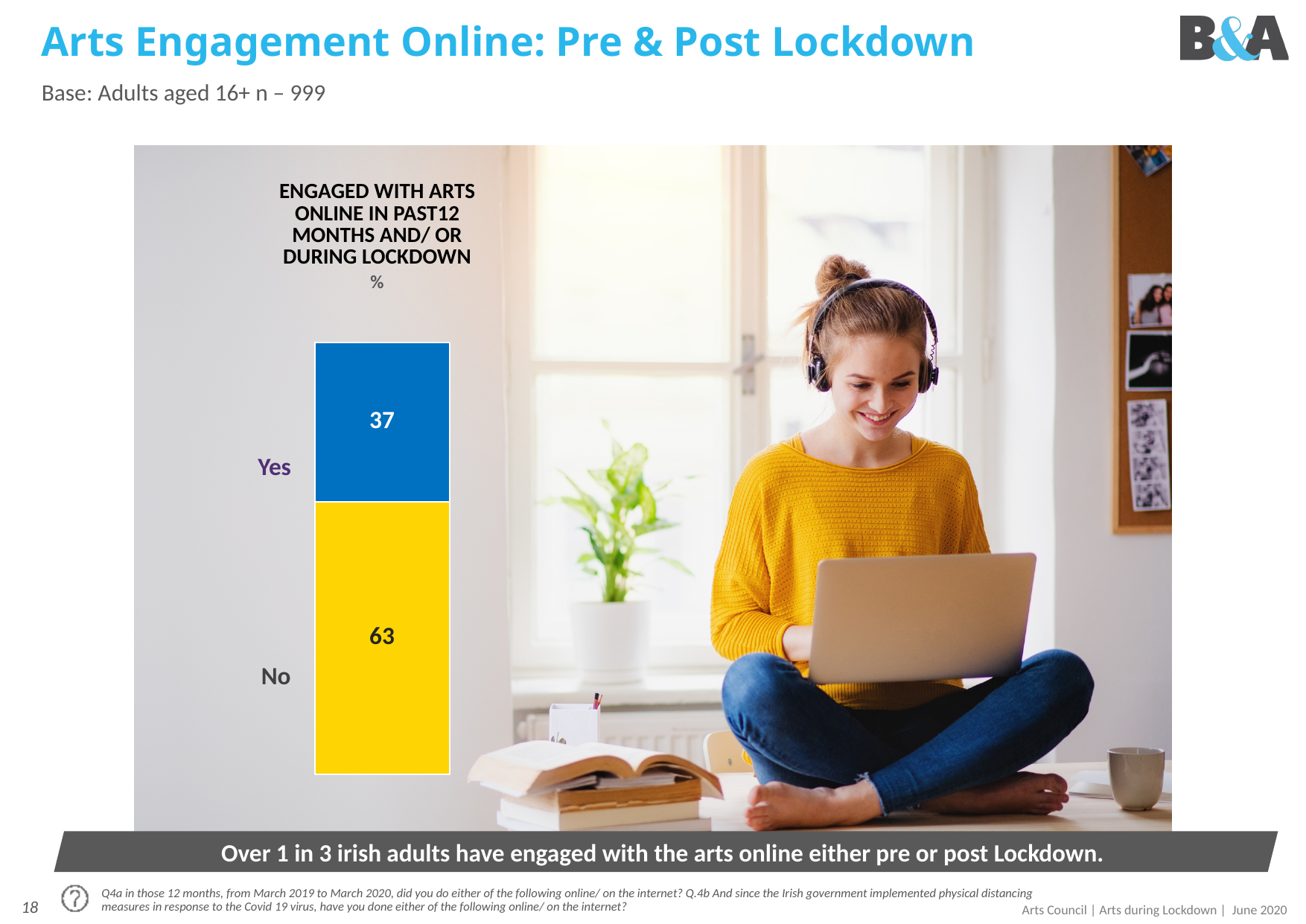
What colour is the No segment of the bar? Yellow Which response, Yes or No, has the larger share in the chart? No Which segment of the stacked bar is the smallest? Yes What percentage of adults answered Yes to having engaged with arts online in the past 12 months and/or during lockdown? 37 Is the value for Yes greater or less than 50? less How many segments does the stacked bar contain? 2 What is the total of the two segments in the stacked bar? 100 What type of chart is shown on the slide? Stacked bar chart What percentage of adults answered No to having engaged with arts online in the past 12 months and/or during lockdown? 63 What colour is the Yes segment of the bar? Blue Which segment of the stacked bar is the largest? No What is the difference in percentage points between the No and Yes segments? 26